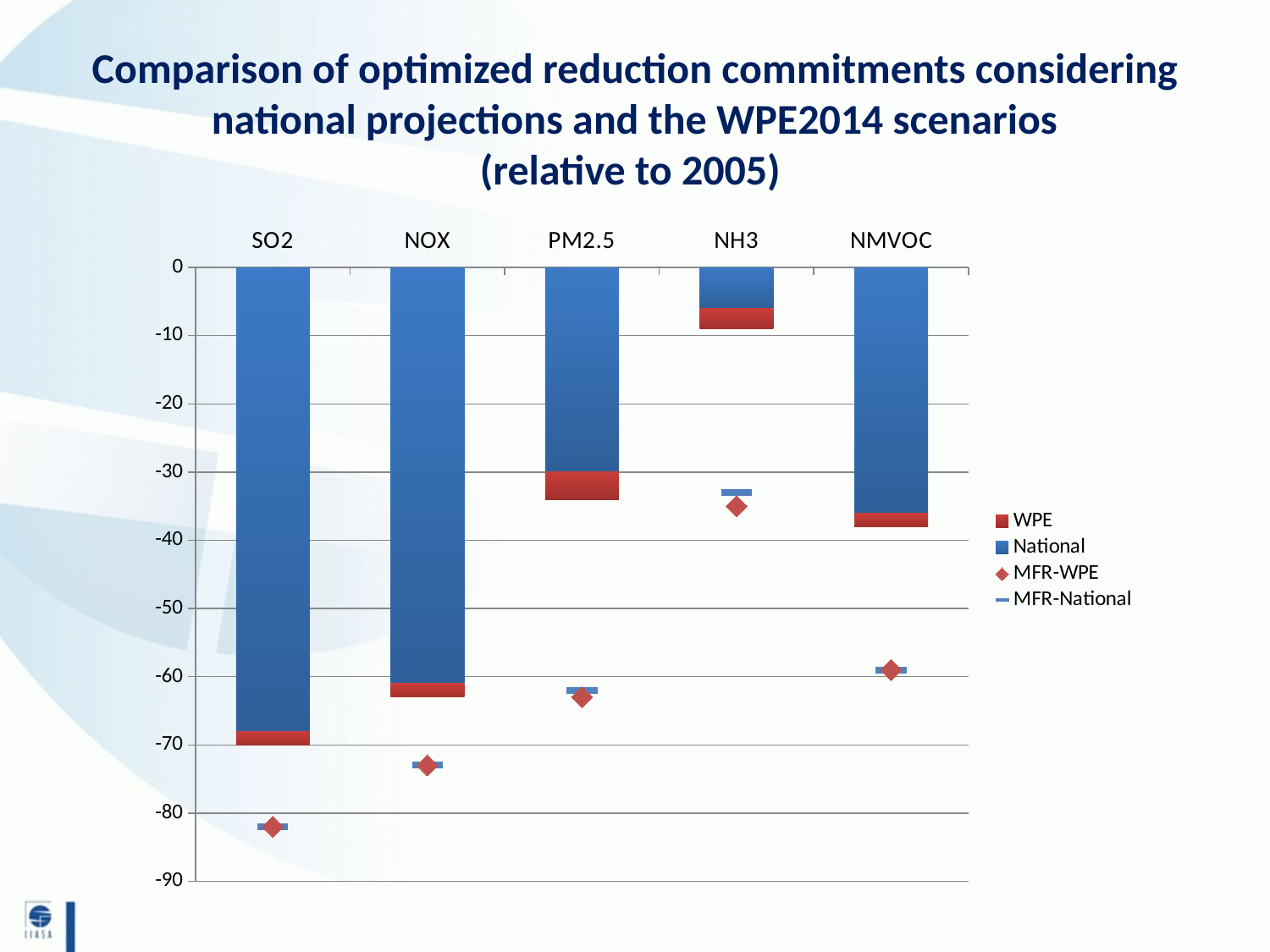
Is the MFR-WPE value for NH3 greater or less than -30? less How many pollutant categories are shown on the x axis? 5 Which category has the lower (more negative) MFR-WPE marker, SO2 or NOX? SO2 What kind of chart is shown on the slide? bar chart Is the National value for NH3 greater or less than -10? greater Which category has the longest bar (the largest reduction)? SO2 Is the MFR-WPE value for NOX greater or less than -70? less What colour is used for the WPE series? red Which category has the shortest bar (the smallest reduction)? NH3 Which category has the lower (more negative) WPE bar end, PM2.5 or NH3? PM2.5 How many series does the legend list? 4